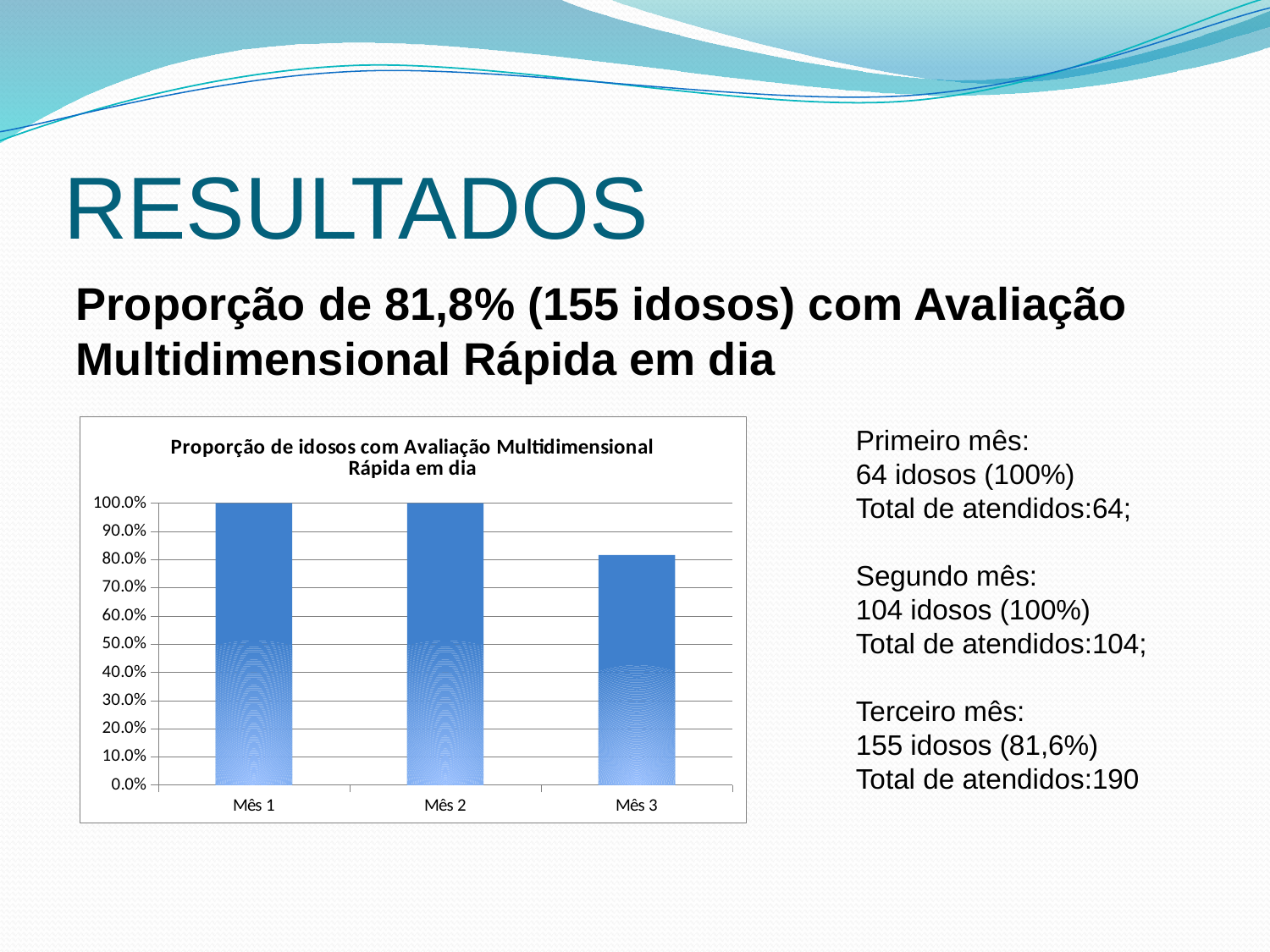
Which is larger, the value for Mês 1 or the value for Mês 3? Mês 1 Do the values rise or fall from Mês 2 to Mês 3? fall What is the title of the chart? Proporção de idosos com Avaliação Multidimensional Rápida em dia What is the difference between the values for Mês 1 and Mês 2? 0.0% Which month has the lowest value on the chart? Mês 3 What is the value for Mês 2 on the chart? 100.0% What kind of chart is shown on the slide? bar chart How many categories (months) are plotted on the chart? 3 Is the value for Mês 3 greater or less than 90.0%? less Is the value for Mês 3 greater or less than 70.0%? greater What is the highest tick label shown on the vertical axis of the chart? 100.0% What is the value for Mês 1 on the chart? 100.0%